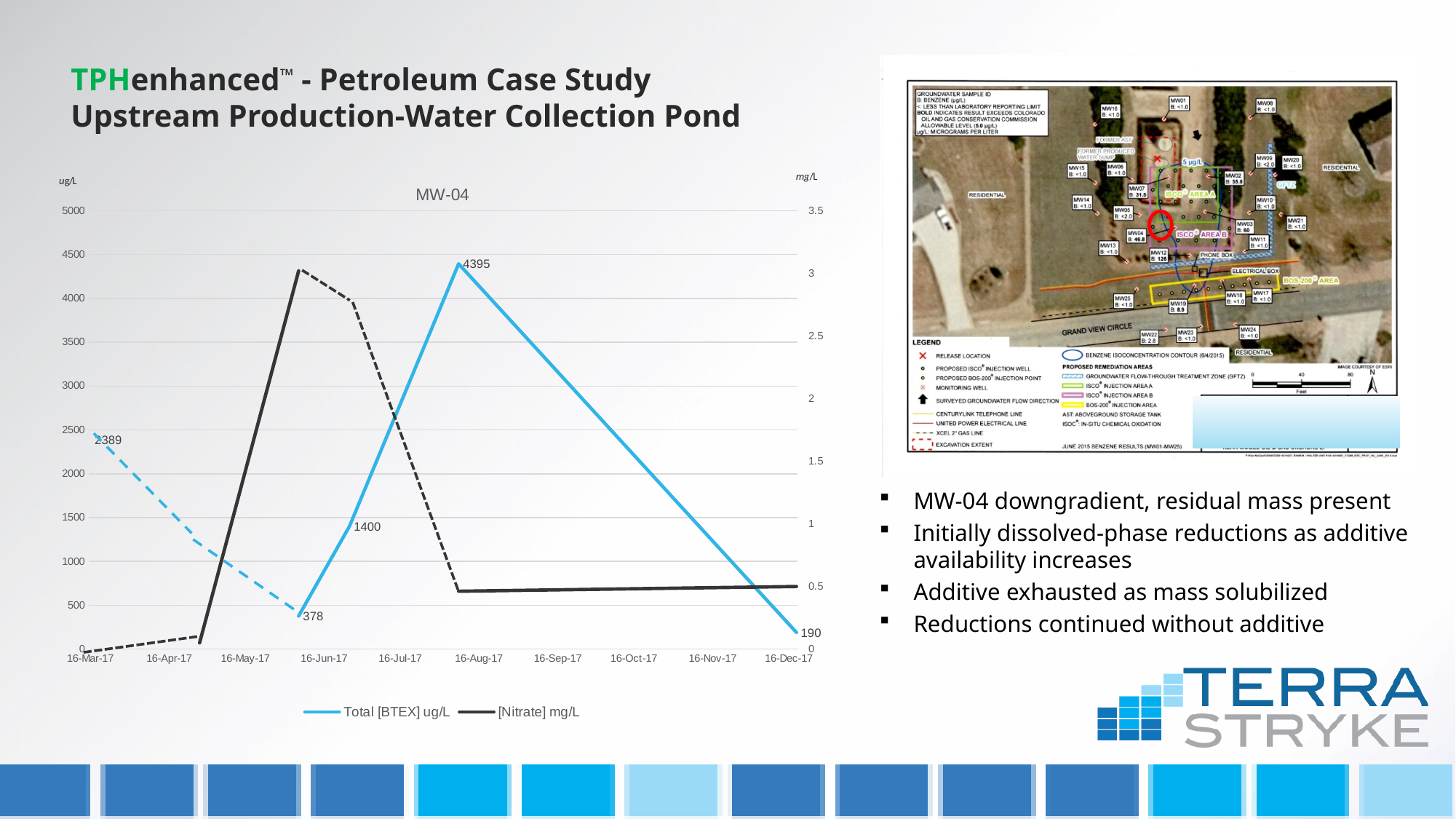
How many series does the legend of the MW-04 chart list? 2 How many dates are shown on the x axis of the MW-04 chart? 10 What is the Total [BTEX] value at 16-Jun-17? 378 What is the difference between the Total [BTEX] values at 16-Aug-17 and 16-Jun-17? 4017 What is the Total [BTEX] value at 16-Dec-17? 190 What kind of chart is shown on the slide? line chart Which is larger, the Total [BTEX] value at 16-Mar-17 or at 16-Dec-17? 16-Mar-17 Is the [Nitrate] value at 16-May-17 greater or less than 2.5 mg/L? less At which date does the Total [BTEX] series reach its highest labeled value? 16-Aug-17 What is the title of the chart? MW-04 What is the Total [BTEX] value at 16-Aug-17? 4395 What is the Total [BTEX] value at 16-Mar-17? 2389